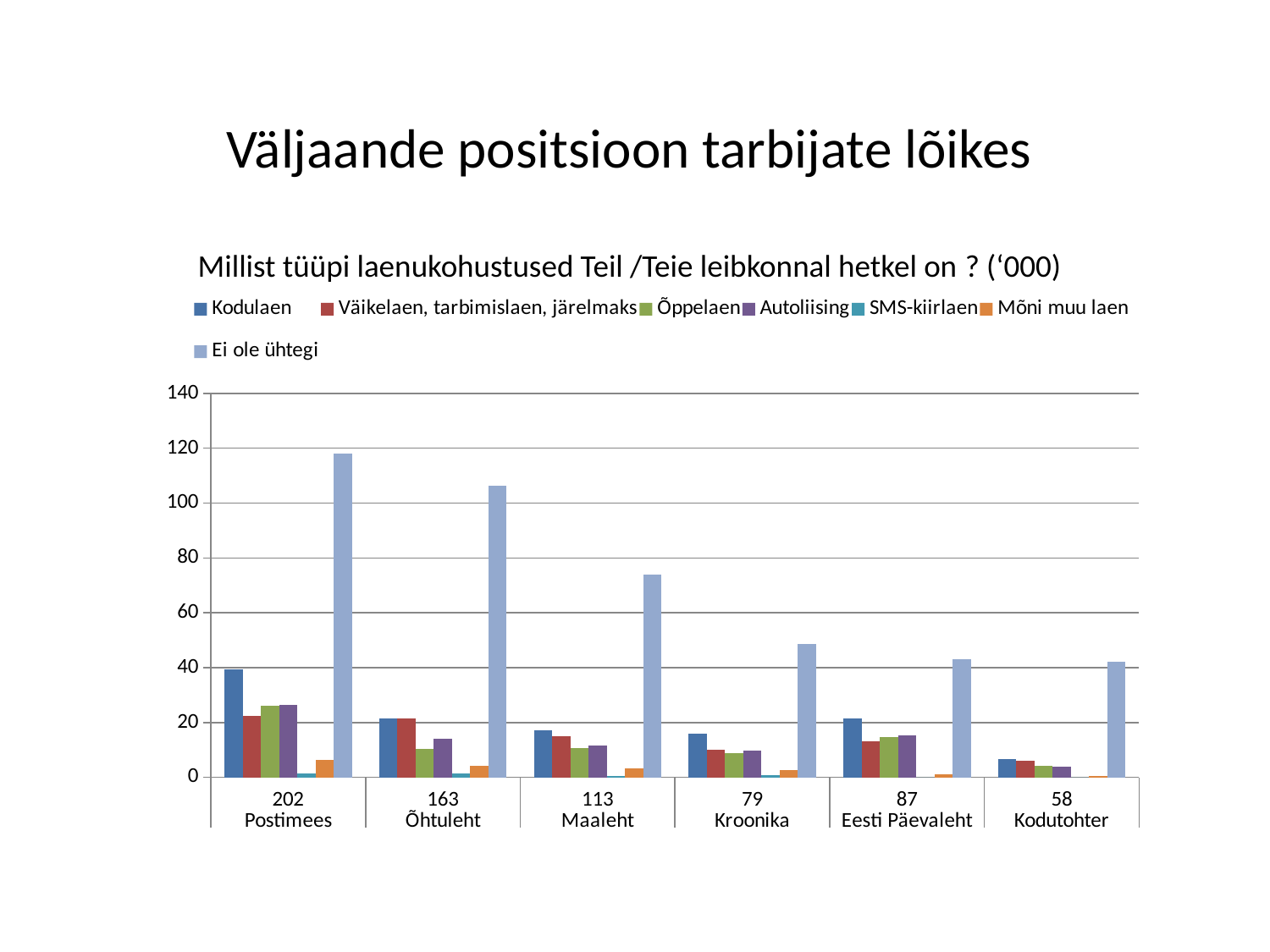
Which publication has the highest value for 'Kodulaen'? Postimees What kind of chart is shown on the slide? bar chart Is the value for 'Ei ole ühtegi' for Kroonika greater or less than 60? less Do the 'Ei ole ühtegi' values rise or fall from Postimees to Kodutohter along the x axis? fall How many series does the legend list? 7 Is the value for 'Ei ole ühtegi' for Postimees greater or less than 100? greater Which is larger: the 'Ei ole ühtegi' value for Õhtuleht or for Maaleht? Õhtuleht Is the value for 'Ei ole ühtegi' for Maaleht greater or less than 80? less Which publication has the lowest value for 'Kodulaen'? Kodutohter How many publications (categories) are shown on the x axis? 6 Which publication has the highest value for 'Ei ole ühtegi'? Postimees What is the title of the chart? Millist tüüpi laenukohustused Teil /Teie leibkonnal hetkel on ? ('000)